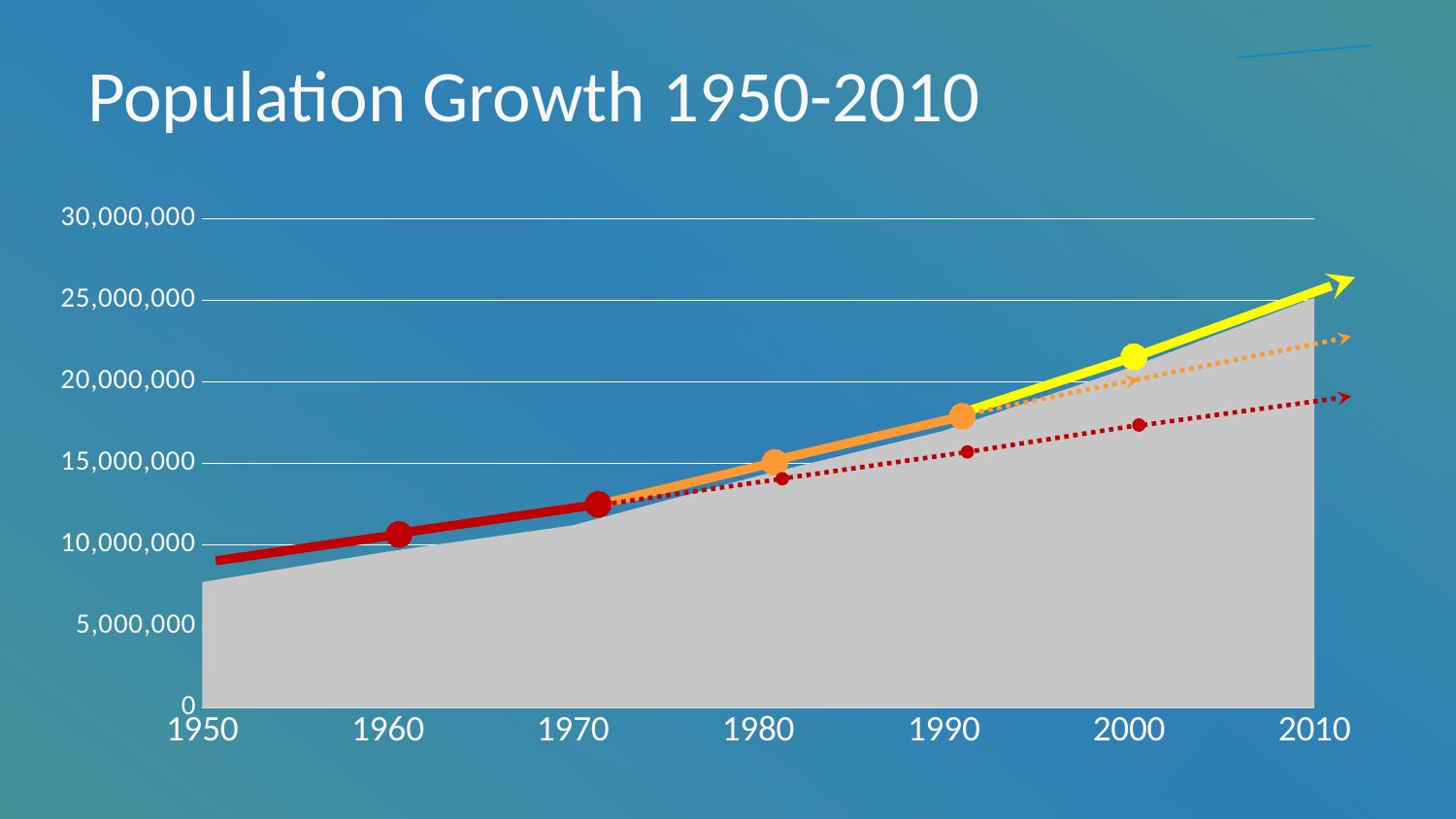
Is the value for 1980 greater or less than 20,000,000? less Which is larger, the value for 2000 or the value for 1970? 2000 What kind of chart is shown on the slide? area chart Is the value for 2010 greater or less than 20,000,000? greater Is the value for 1990 greater or less than 15,000,000? greater Do the values rise or fall from 1950 to 2010? rise Which year has the highest population value? 2010 How many years are labelled on the x axis? 7 What is the title of the chart? Population Growth 1950-2010 What is the highest value labelled on the y axis? 30,000,000 Which year has the lowest population value? 1950